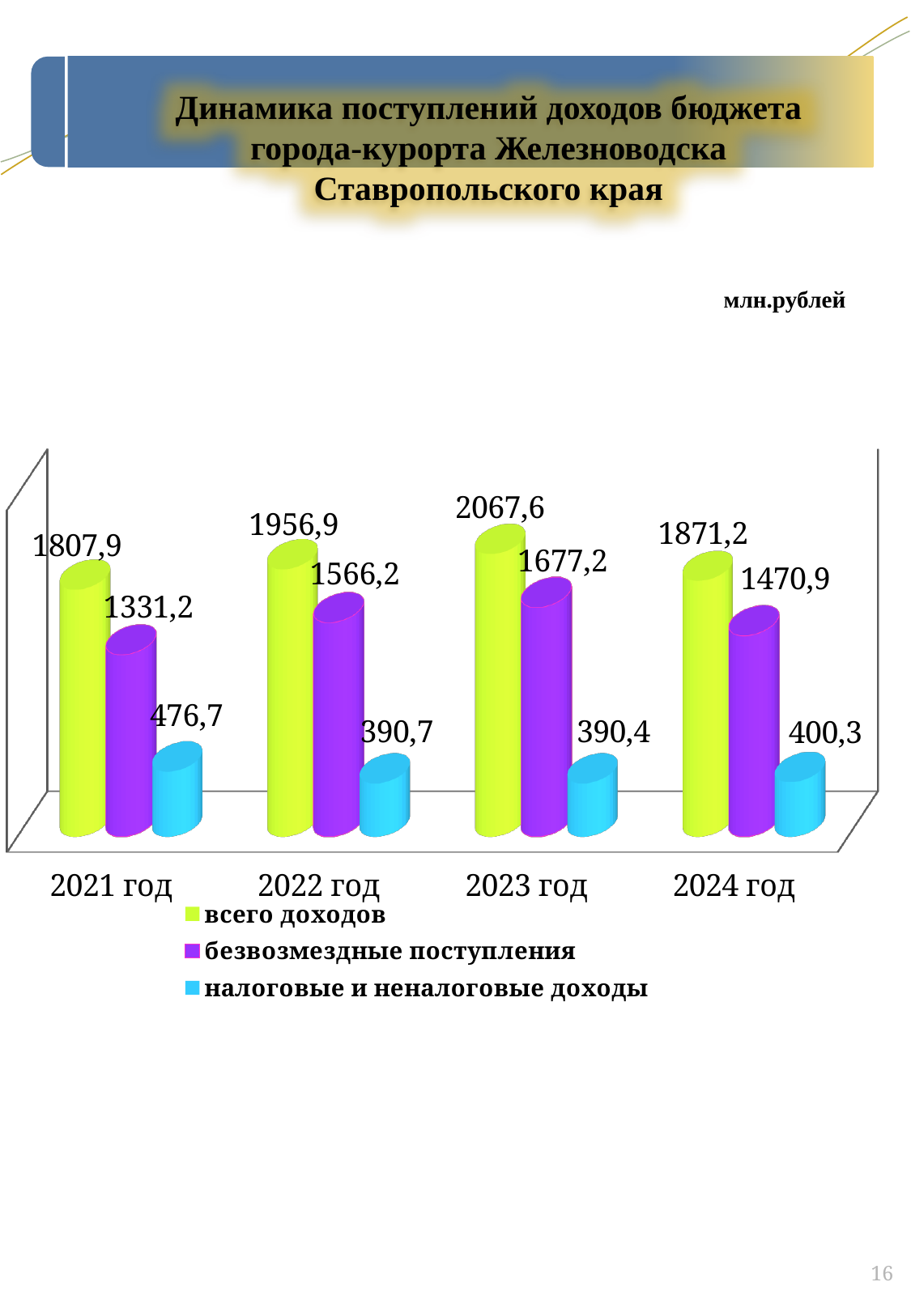
In which year is всего доходов the highest? 2023 год What kind of chart is shown on the slide? bar chart What is the value for налоговые и неналоговые доходы in 2024 год? 400,3 What is the difference between всего доходов in 2023 год and in 2024 год? 196,4 Which is larger: безвозмездные поступления in 2022 год or in 2024 год? 2022 год How many series does the legend list? 3 What is the value for всего доходов in 2023 год? 2067,6 Does всего доходов rise or fall from 2021 год to 2023 год? rise What is the difference between налоговые и неналоговые доходы in 2021 год and in 2024 год? 76,4 In which year is налоговые и неналоговые доходы the lowest? 2023 год How many years are shown on the x axis? 4 What is the value for безвозмездные поступления in 2021 год? 1331,2